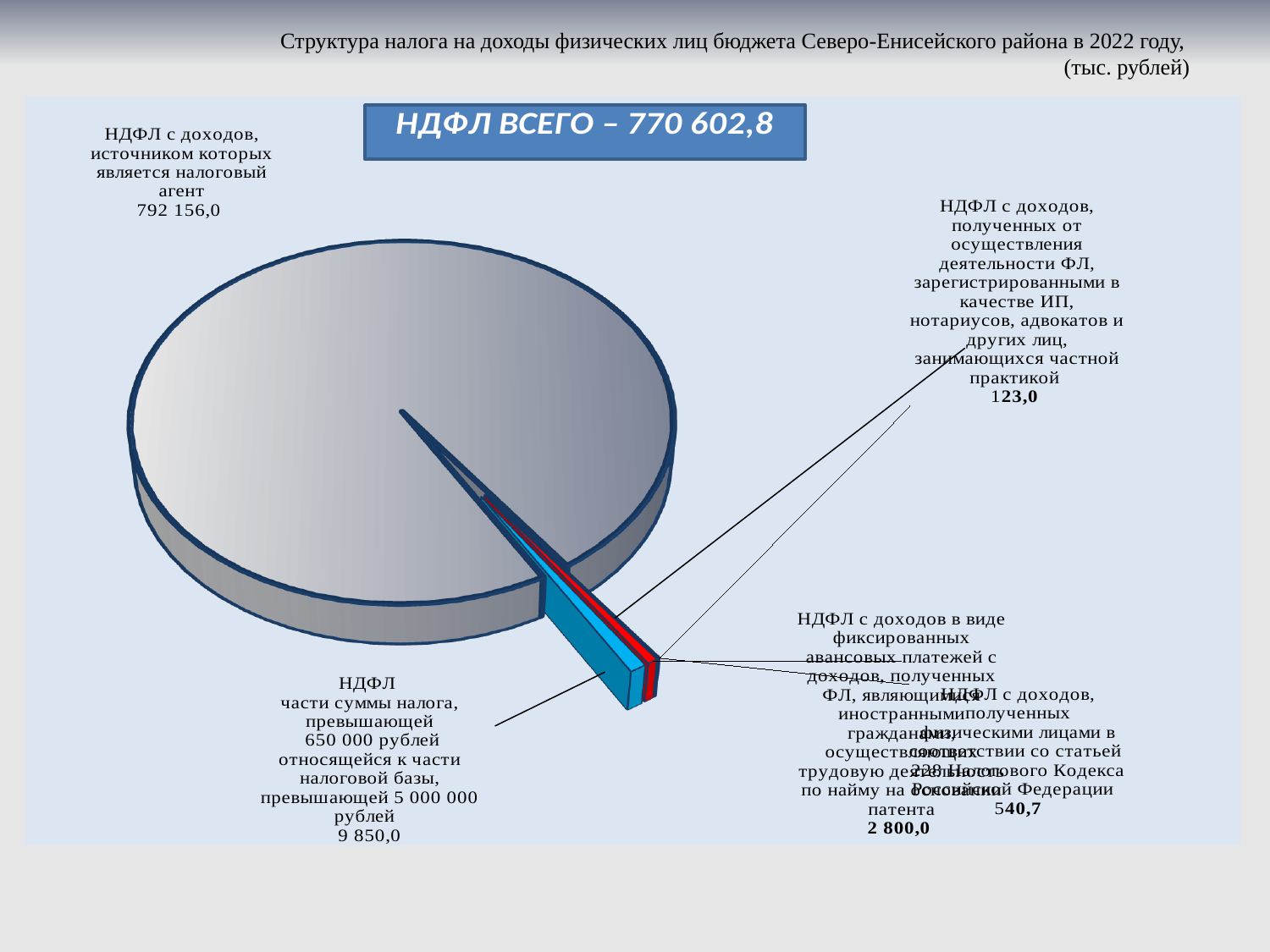
Which is larger: the value for the patent-based advance payments or the value for income under статья 228? patent-based advance payments (2 800,0) Which category has the smallest value? НДФЛ с доходов, полученных от осуществления деятельности ФЛ, зарегистрированными в качестве ИП, нотариусов, адвокатов и других лиц, занимающихся частной практикой What is the difference between the value for the part of the tax exceeding 650 000 рублей (9 850,0) and the value for ИП, нотариусов, адвокатов (123,0)? 9 727,0 What is the value for НДФЛ from income received by individuals under статья 228 of the Налоговый Кодекс? 540,7 What is the value for НДФЛ from fixed advance payments of foreign citizens working on the basis of a patent? 2 800,0 What is the value for НДФЛ from income of individuals registered as ИП, нотариусов, адвокатов and others in private practice? 123,0 What is the value for НДФЛ on the part of the tax exceeding 650 000 рублей (tax base over 5 000 000 рублей)? 9 850,0 How many categories are labelled on the pie chart? 5 Which category has the largest slice of the pie? НДФЛ с доходов, источником которых является налоговый агент What kind of chart is shown on the slide? pie chart What total value of НДФЛ ВСЕГО is shown in the box above the chart? 770 602,8 What is the value for "НДФЛ с доходов, источником которых является налоговый агент"? 792 156,0